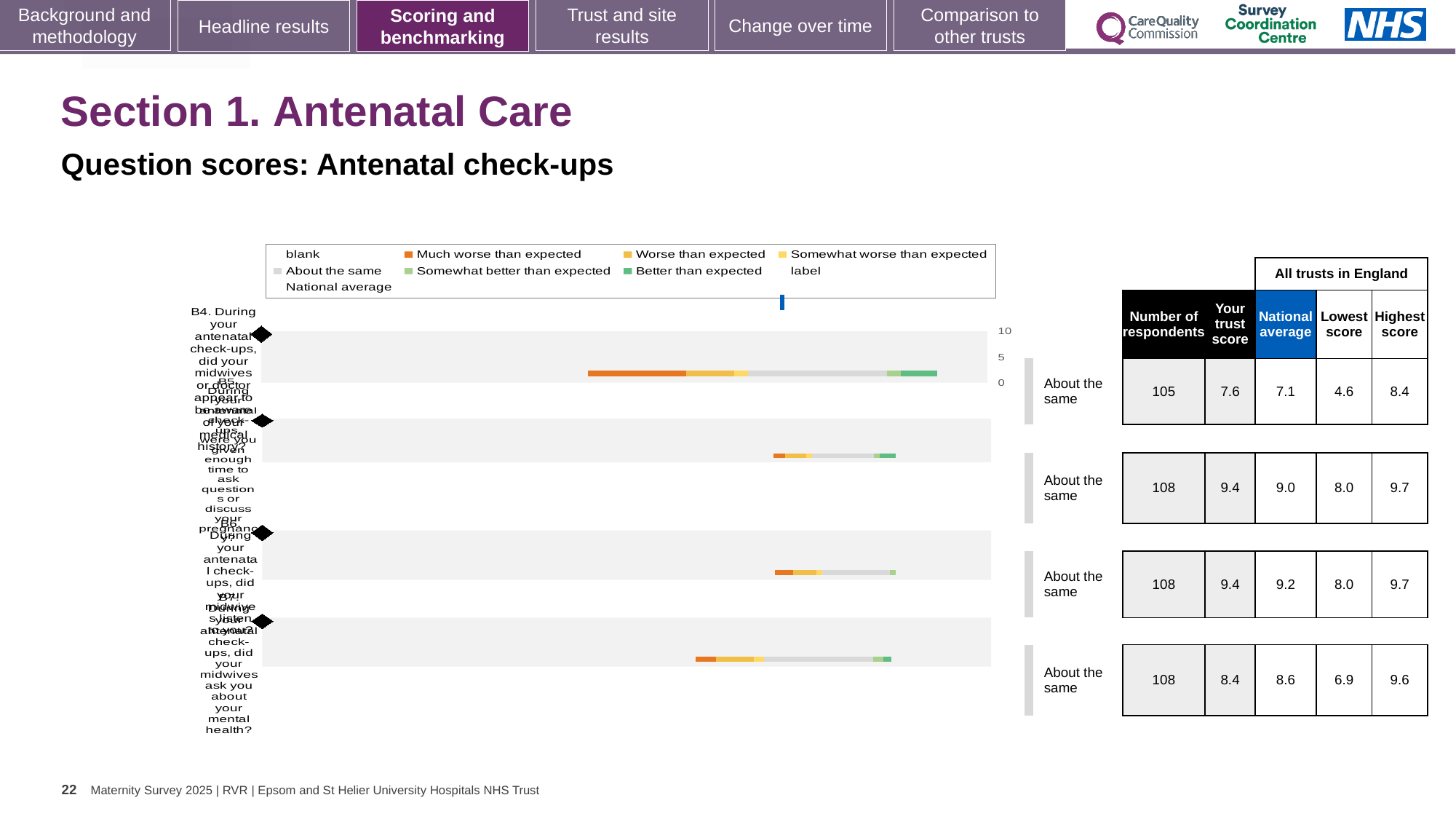
In the table beside the chart, what is the lowest score for the first question (B4)? 4.6 For the first question (B4), what is the difference between the trust score and the national average? 0.5 How many entries does the chart legend list? 9 How many question bars are plotted in the chart? 4 In the table beside the chart, what is the national average for the last question (B7, about mental health)? 8.6 In the table beside the chart, what is the number of respondents for the first question (B4)? 105 What is the highest tick value shown on the chart's axis? 10 What kind of chart is shown on the slide? bar chart In the table beside the chart, what is the highest score for the last question (B7, about mental health)? 9.6 Which question row has the lowest number of respondents in the table beside the chart? B4 (105) In the table beside the chart, what is the trust score for the first question (B4)? 7.6 For the first question (B4), is the trust score or the national average larger? trust score